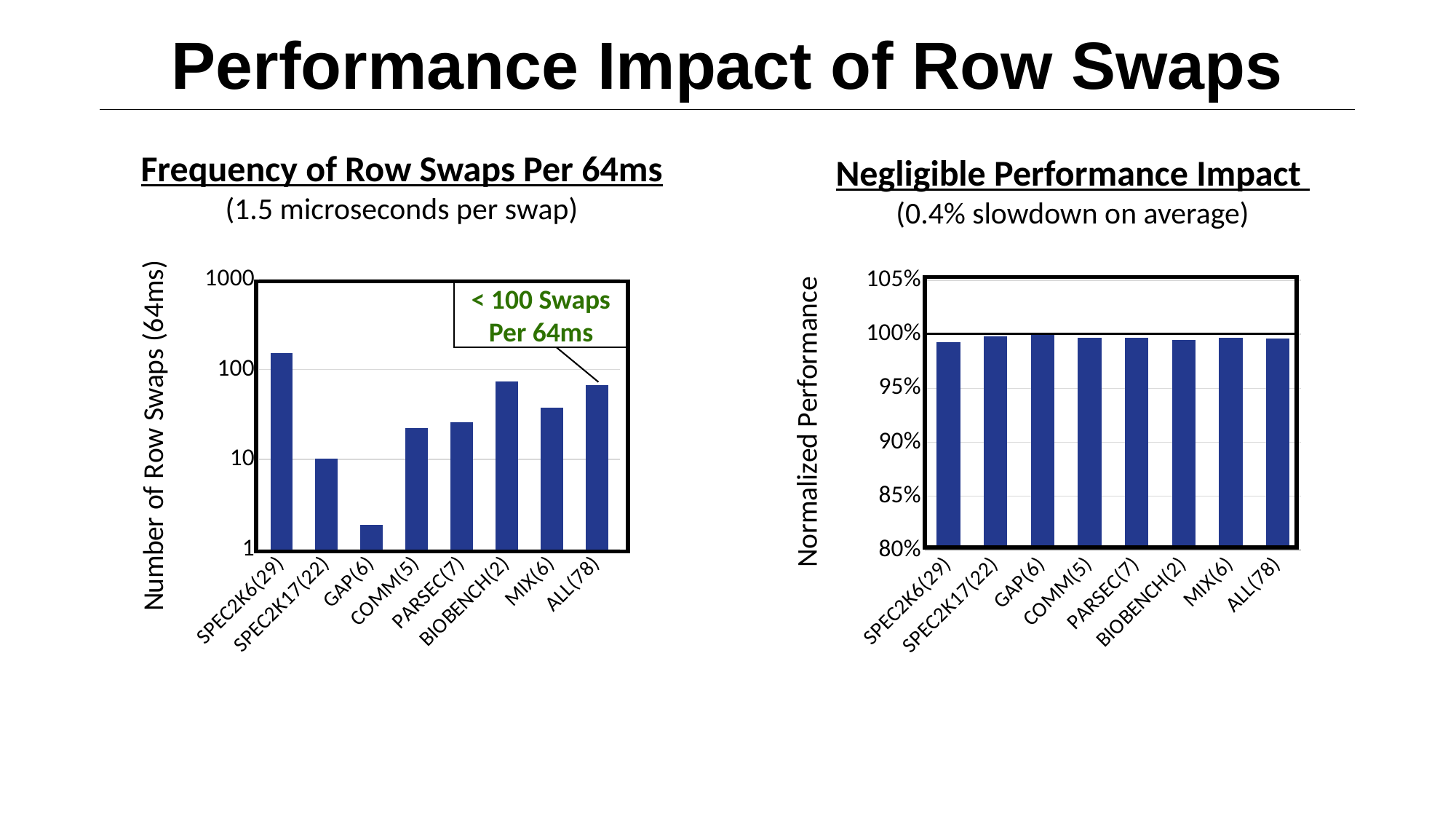
In the 'Frequency of Row Swaps Per 64ms' chart, which category has the lowest number of row swaps? GAP(6) How many bars are shown in the 'Negligible Performance Impact' chart on the right? 8 In the 'Frequency of Row Swaps Per 64ms' chart, which has more row swaps, BIOBENCH(2) or MIX(6)? BIOBENCH(2) In the 'Frequency of Row Swaps Per 64ms' chart, which category has the highest number of row swaps? SPEC2K6(29) What kind of chart is the 'Frequency of Row Swaps Per 64ms' chart on the left? bar chart In the 'Frequency of Row Swaps Per 64ms' chart, is the value for SPEC2K6(29) greater or less than 100? greater In the 'Frequency of Row Swaps Per 64ms' chart, which has more row swaps, SPEC2K17(22) or COMM(5)? COMM(5) In the 'Frequency of Row Swaps Per 64ms' chart, is the value for ALL(78) greater or less than 100? less How many categories are shown on the x axis of the 'Frequency of Row Swaps Per 64ms' chart? 8 In the 'Negligible Performance Impact' chart, is the normalized performance for SPEC2K6(29) greater or less than 95%? greater What does the callout annotation on the 'Frequency of Row Swaps Per 64ms' chart say? < 100 Swaps Per 64ms